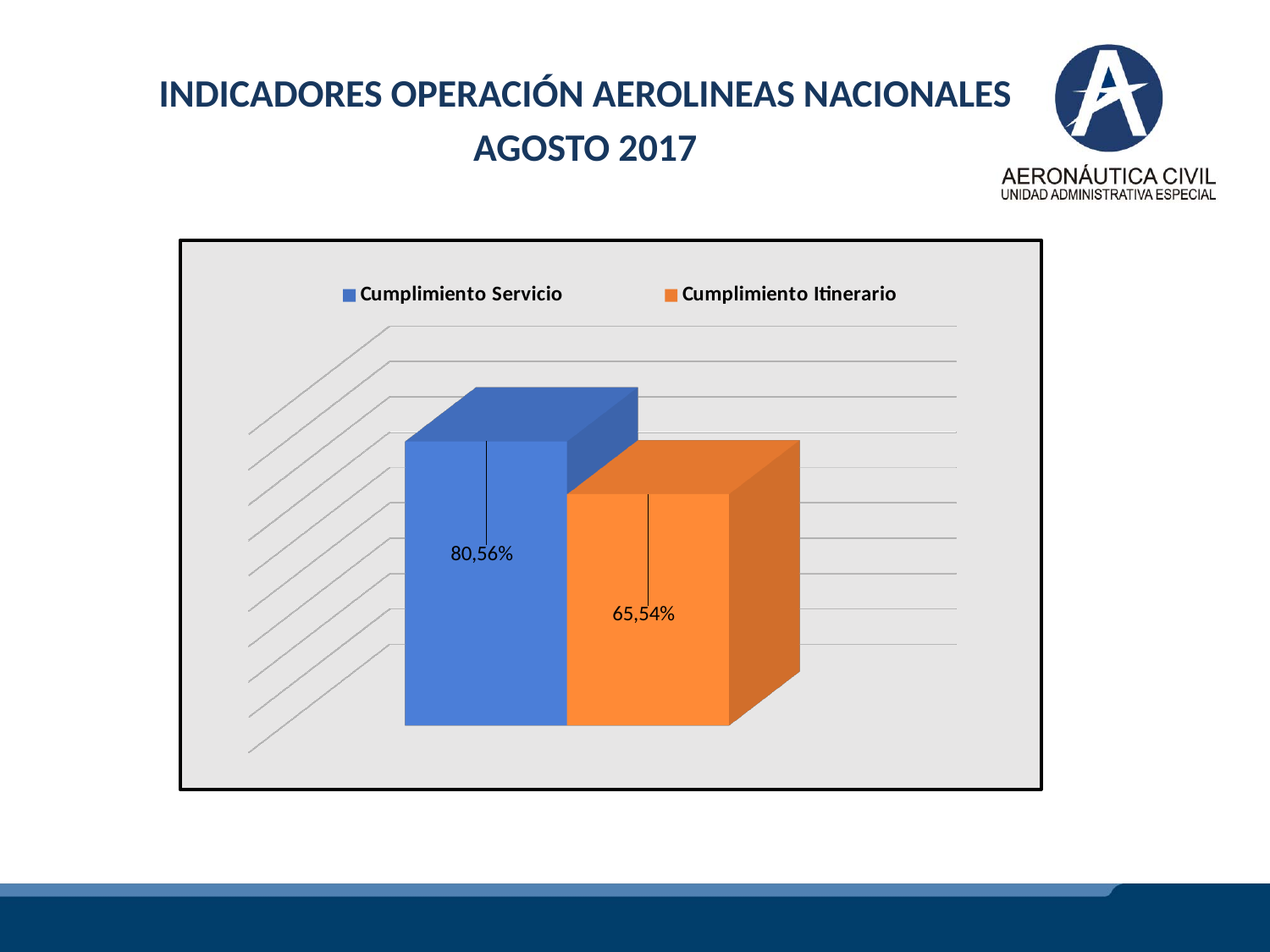
Which series has the lowest value on the chart? Cumplimiento Itinerario How many bars are plotted on the chart? 2 How many series does the legend list? 2 What is the difference between the Cumplimiento Servicio value and the Cumplimiento Itinerario value? 15,02% Which series has the higher value, Cumplimiento Servicio or Cumplimiento Itinerario? Cumplimiento Servicio Which series has the highest value on the chart? Cumplimiento Servicio What kind of chart is shown on the slide? Bar chart What is the value for Cumplimiento Servicio? 80,56% What is the value for Cumplimiento Itinerario? 65,54% What colour is the bar for Cumplimiento Servicio? Blue What colour is the bar for Cumplimiento Itinerario? Orange